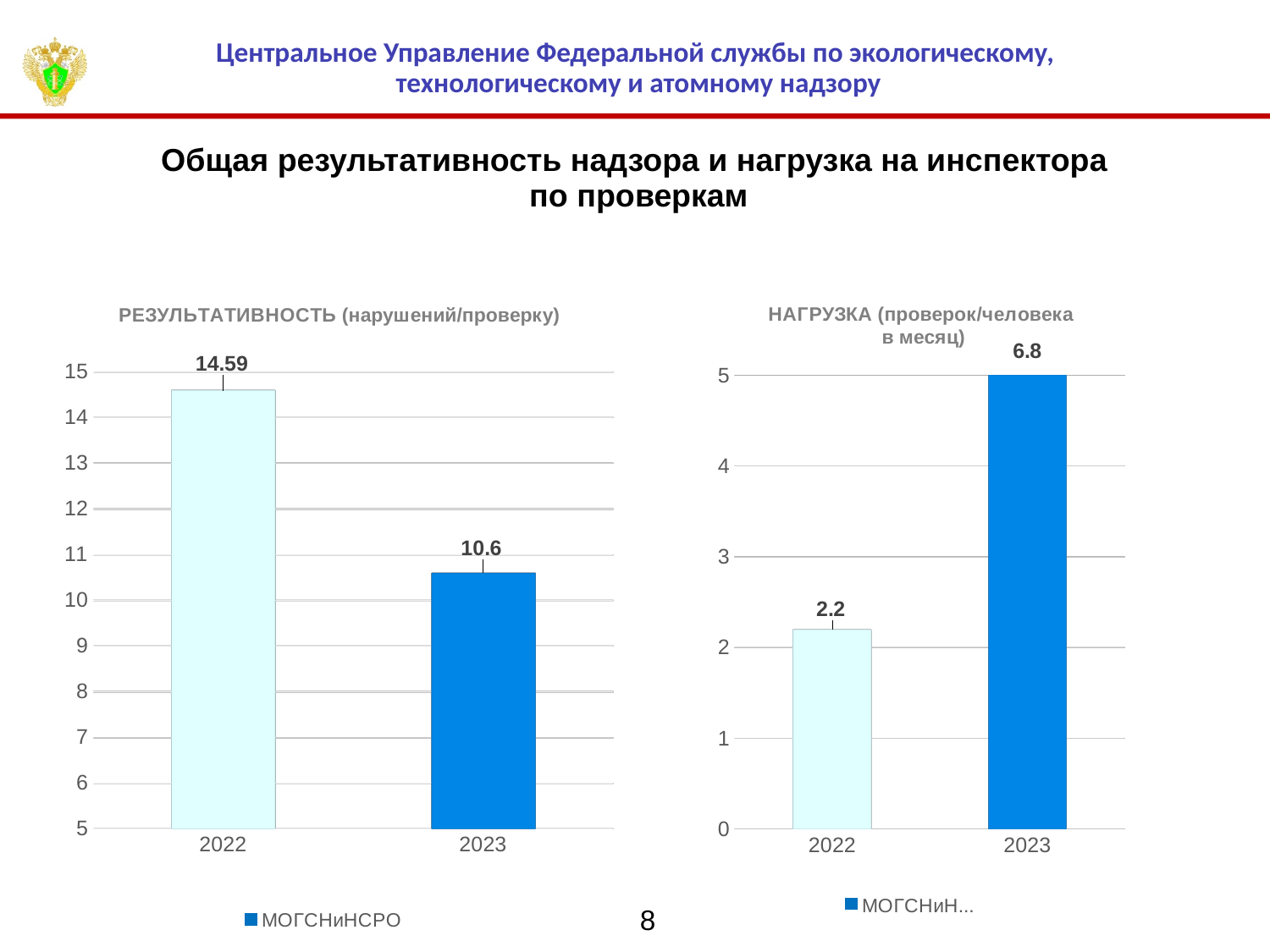
In the НАГРУЗКА chart on the right, what is the value for 2023? 6.8 In the НАГРУЗКА chart on the right, what is the value for 2022? 2.2 In the НАГРУЗКА chart on the right, which year has the lower value? 2022 In the НАГРУЗКА chart on the right, what is the difference between the 2023 and 2022 values? 4.6 In the РЕЗУЛЬТАТИВНОСТЬ chart on the left, what is the value for 2023? 10.6 In the НАГРУЗКА chart on the right, is the value for 2023 larger or smaller than the value for 2022? larger In the РЕЗУЛЬТАТИВНОСТЬ chart on the left, which year has the higher value? 2022 How many categories (years) are shown in the НАГРУЗКА chart on the right? 2 In the РЕЗУЛЬТАТИВНОСТЬ chart on the left, what is the difference between the 2022 and 2023 values? 3.99 In the РЕЗУЛЬТАТИВНОСТЬ chart on the left, what is the value for 2022? 14.59 What type of chart is the РЕЗУЛЬТАТИВНОСТЬ chart on the left? bar chart In the РЕЗУЛЬТАТИВНОСТЬ chart on the left, do the values rise or fall from 2022 to 2023? fall